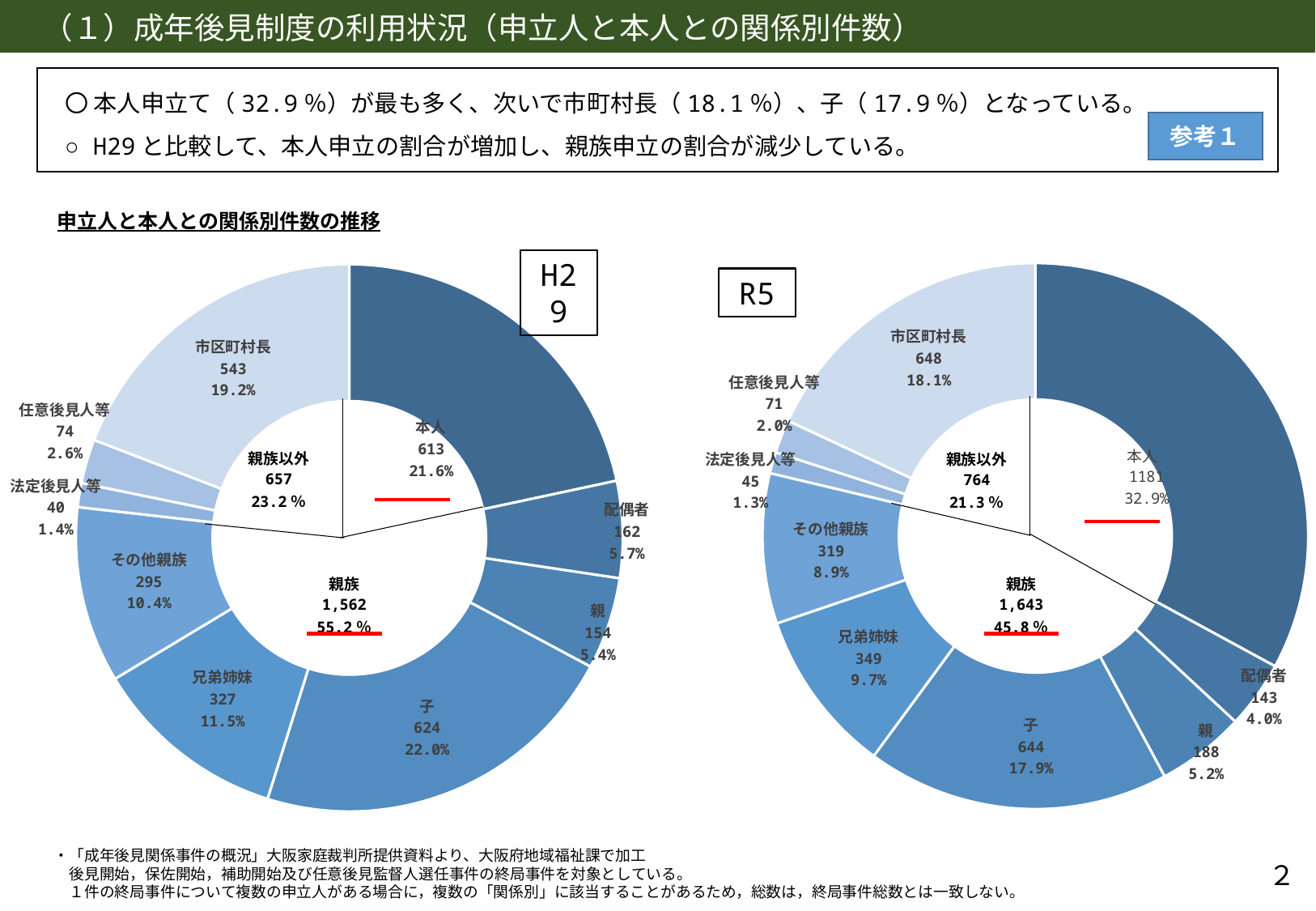
In the R5 chart, how many cases are shown for 市区町村長? 648 In the H29 chart, what is the number of cases for 子? 624 In the R5 chart, what percentage share is shown for 本人? 32.9% How many outer-ring categories are shown in the R5 chart? 9 In the R5 chart, what is the difference in cases between 本人 and 子? 537 What type of chart is used for the H29 and R5 data on this slide? Donut (pie) chart In the R5 chart, which category has the smallest number of cases? 法定後見人等 In the H29 chart, which category has the smallest share? 法定後見人等 In the R5 chart, what is the number of cases shown for 親族以外 in the inner ring? 764 In the H29 chart, what is the share shown for 親族 in the inner ring? 55.2% In the H29 chart, which is larger: the number of cases for 兄弟姉妹 or その他親族? 兄弟姉妹 In the H29 chart, which category has the largest number of cases? 子